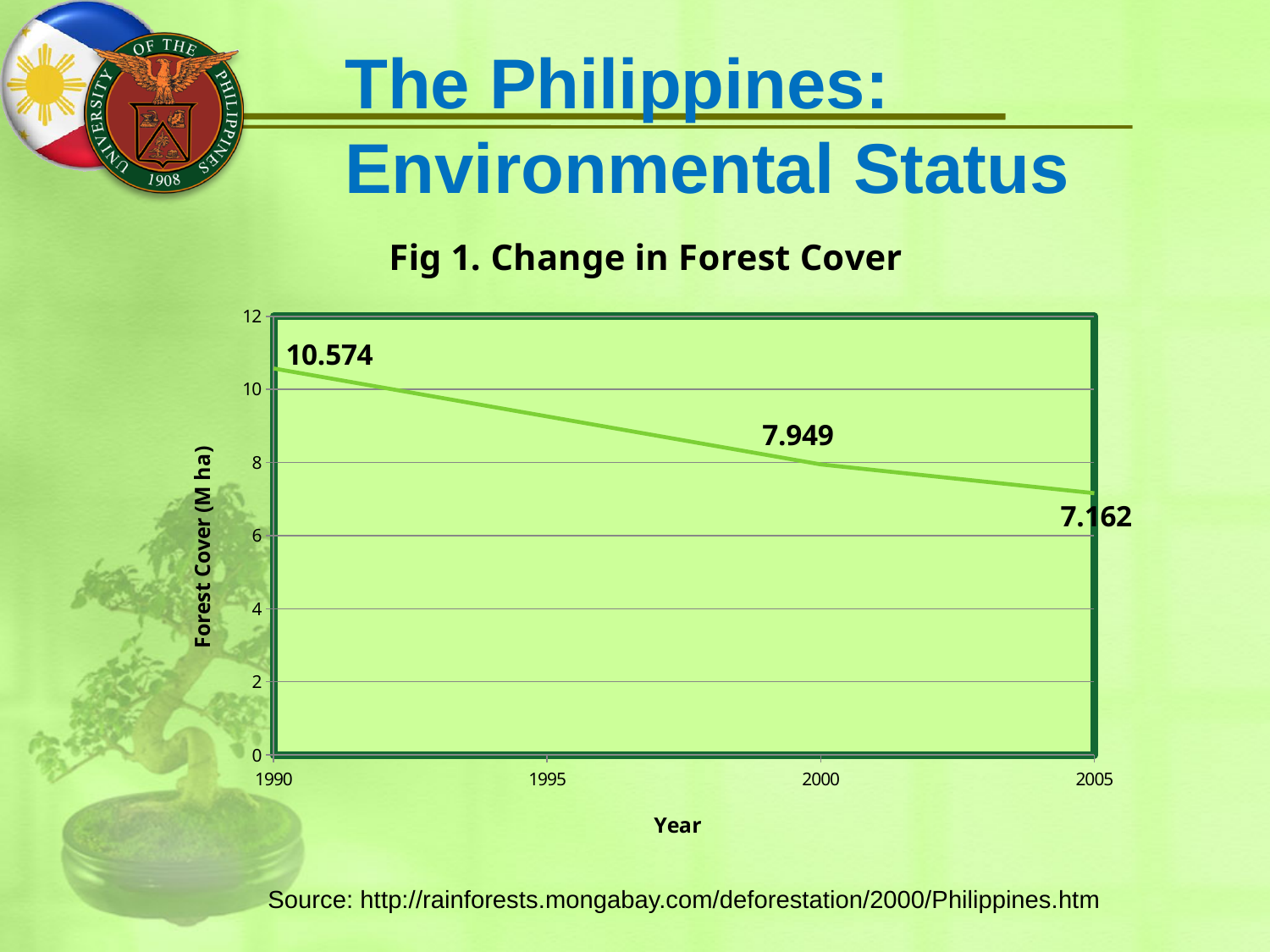
What is the forest cover value shown for 2005? 7.162 How many data points are labelled on the line? 3 What is the difference between the forest cover values for 2000 and 2005? 0.787 What is the forest cover value shown for 2000? 7.949 What kind of chart is shown on the slide? line chart Which is larger, the forest cover value for 1990 or for 2000? 1990 Which year has the highest forest cover value? 1990 What is the forest cover value shown for 1990? 10.574 Does the forest cover rise or fall from 1990 to 2005? fall What is the title of the y axis? Forest Cover (M ha) What is the difference between the forest cover values for 1990 and 2005? 3.412 Which year has the lowest forest cover value? 2005